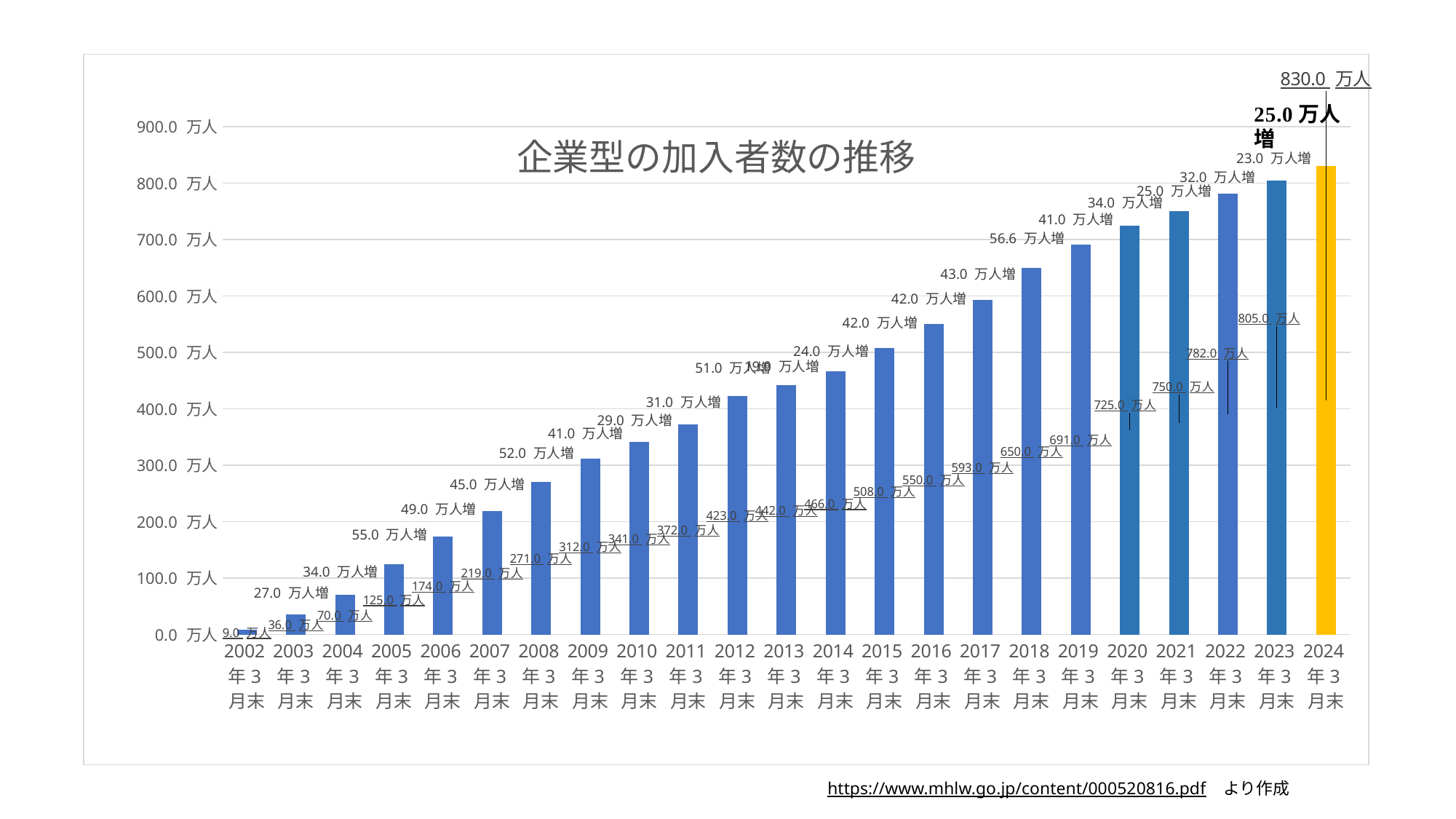
What is the title of the chart? 企業型の加入者数の推移 What kind of chart is shown? bar chart Which is larger, the value for 2015年3月末 or the value for 2016年3月末? 2016年3月末 Is the value for 2019年3月末 greater or less than 600.0 万人? greater How many bars are plotted in the chart? 23 What is the value for 2002年3月末? 9.0 万人 What is the difference between the values for 2023年3月末 and 2022年3月末? 23.0 万人 What is the value for 2024年3月末? 830.0 万人 Do the values rise or fall from 2002 to 2024? rise What is the value for 2012年3月末? 423.0 万人 Which year has the highest value? 2024年3月末 Which year has the lowest value? 2002年3月末